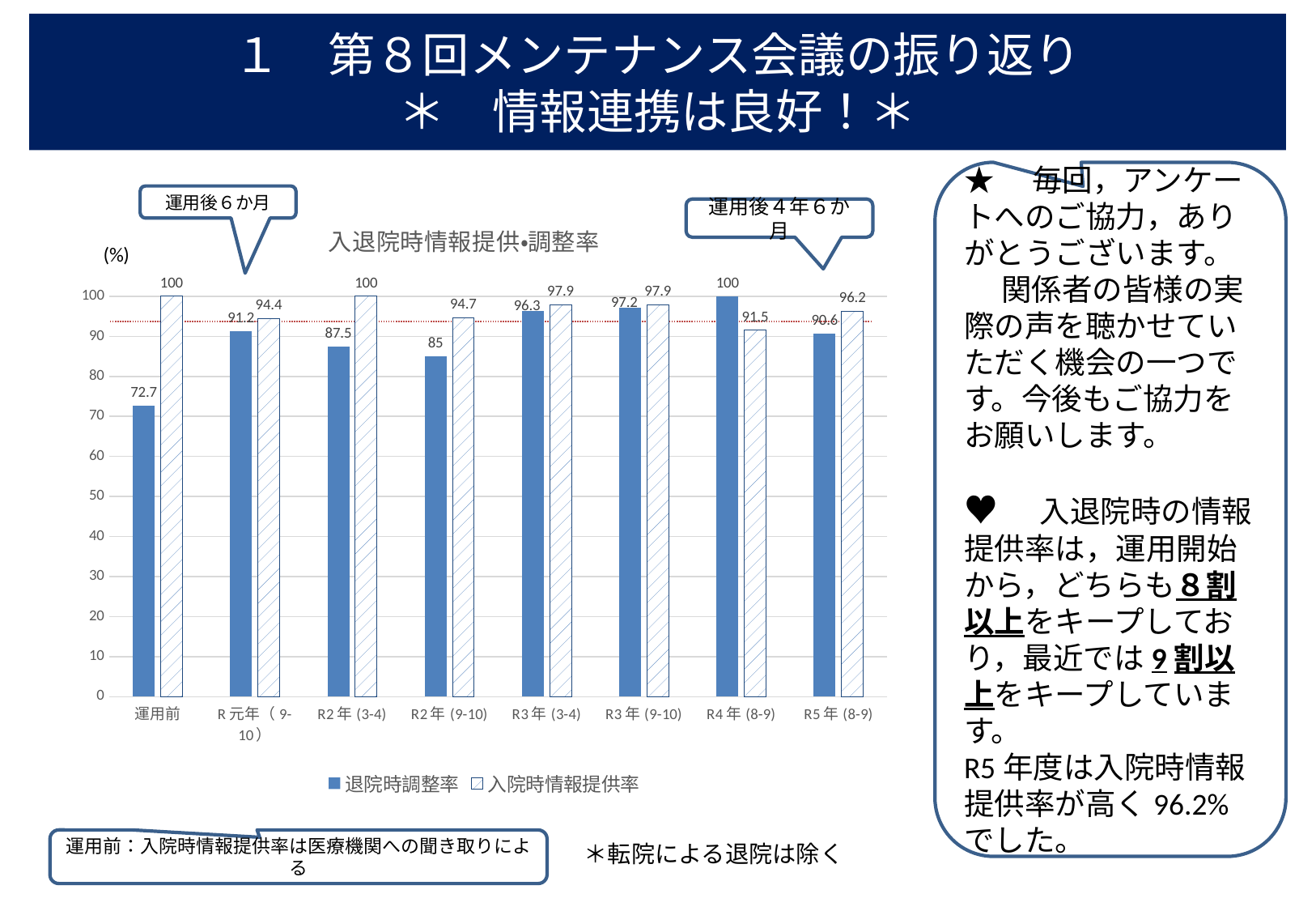
What is the value of 入院時情報提供率 for R5年(8-9)? 96.2 What is the title of the chart? 入退院時情報提供•調整率 What is the difference between 入院時情報提供率 and 退院時調整率 for 運用前? 27.3 How many series does the legend list? 2 Which category has the lowest value for 退院時調整率? 運用前 For R4年(8-9), which is larger: 退院時調整率 or 入院時情報提供率? 退院時調整率 Which category has the highest value for 退院時調整率? R4年(8-9) What is the value of 退院時調整率 for R2年(9-10)? 85 How many categories are shown on the x axis? 8 What is the value of 退院時調整率 for 運用前? 72.7 What is the value of 入院時情報提供率 for R4年(8-9)? 91.5 What kind of chart is shown on the slide? bar chart